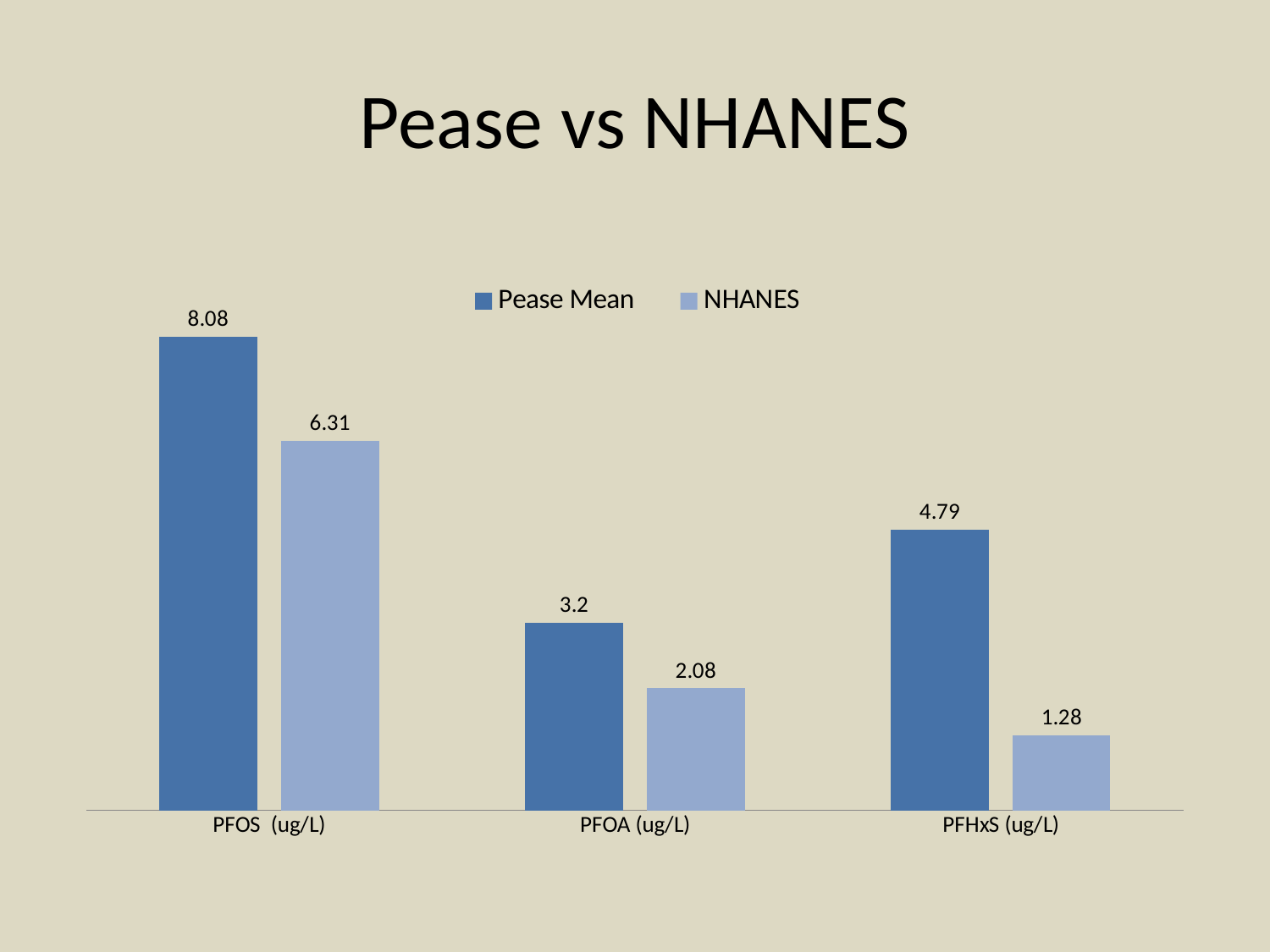
Which category has the highest Pease Mean value? PFOS (ug/L) What is the NHANES value for PFOA (ug/L)? 2.08 What is the title of the chart? Pease vs NHANES How many categories are shown on the x axis? 3 What kind of chart is shown on the slide? Bar chart What is the difference between the Pease Mean and NHANES values for PFOS (ug/L)? 1.77 How many series does the legend list? 2 What is the Pease Mean value for PFOS (ug/L)? 8.08 What is the NHANES value for PFHxS (ug/L)? 1.28 Which is larger for PFOA (ug/L): the Pease Mean value or the NHANES value? Pease Mean Which category has the lowest NHANES value? PFHxS (ug/L) What is the difference between the Pease Mean and NHANES values for PFHxS (ug/L)? 3.51